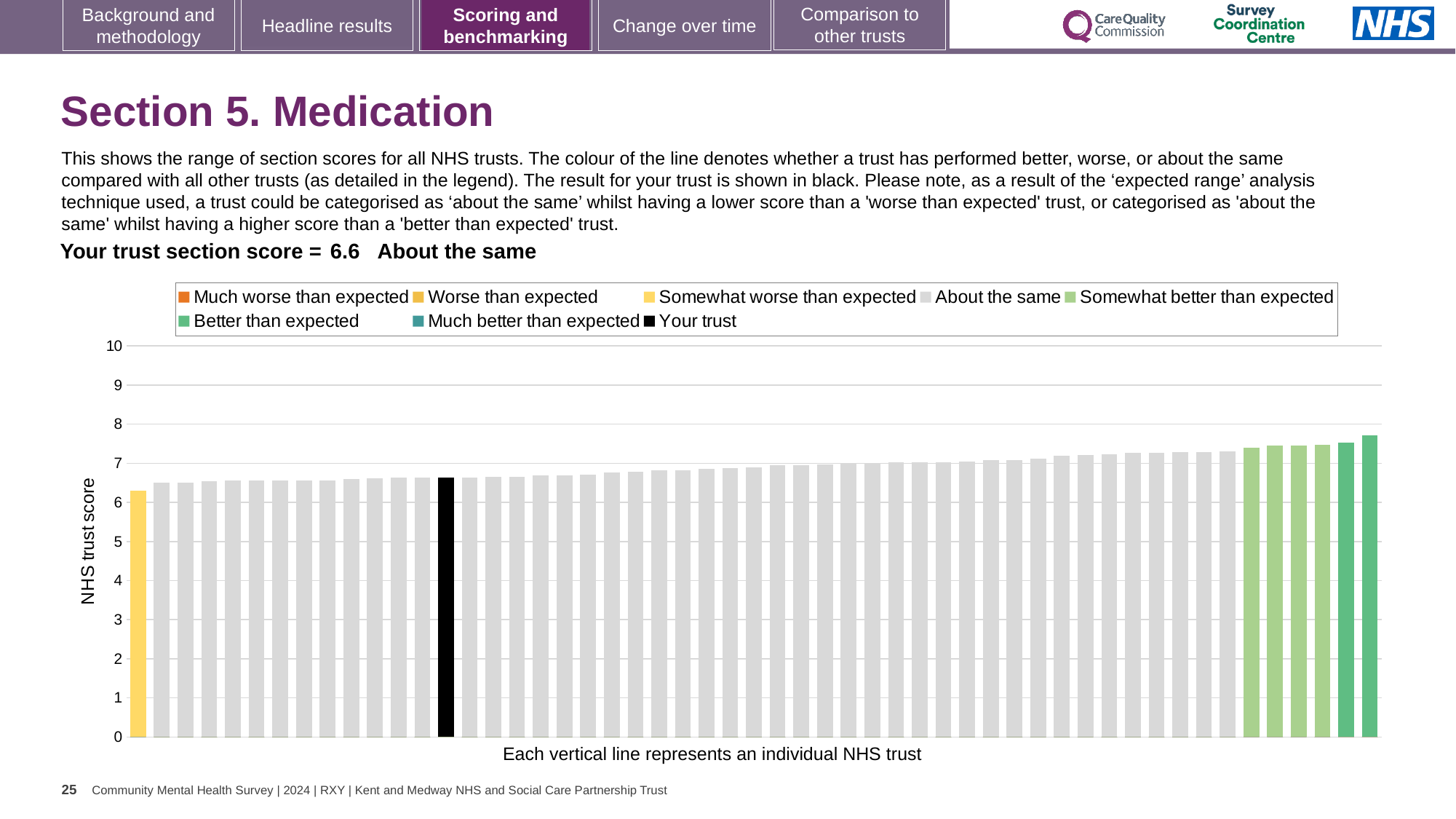
Do the bar values rise or fall from left to right along the x axis? rise How many bars are coloured yellow (Somewhat worse than expected)? 1 Is the value for the leftmost (yellow) bar greater or less than 6? greater Is the value for the tallest bar greater or less than 8? less Which is larger: the value of the black 'Your trust' bar or the value of the rightmost bar? the rightmost bar How many entries does the chart legend list? 8 What is the label on the vertical axis? NHS trust score What kind of chart is shown on the slide? bar chart What is the section score for your trust shown on the slide? 6.6 Which category is your trust placed in for this section? About the same Is the value for the black 'Your trust' bar greater or less than 7? less What colour is used for the 'Your trust' bar? black